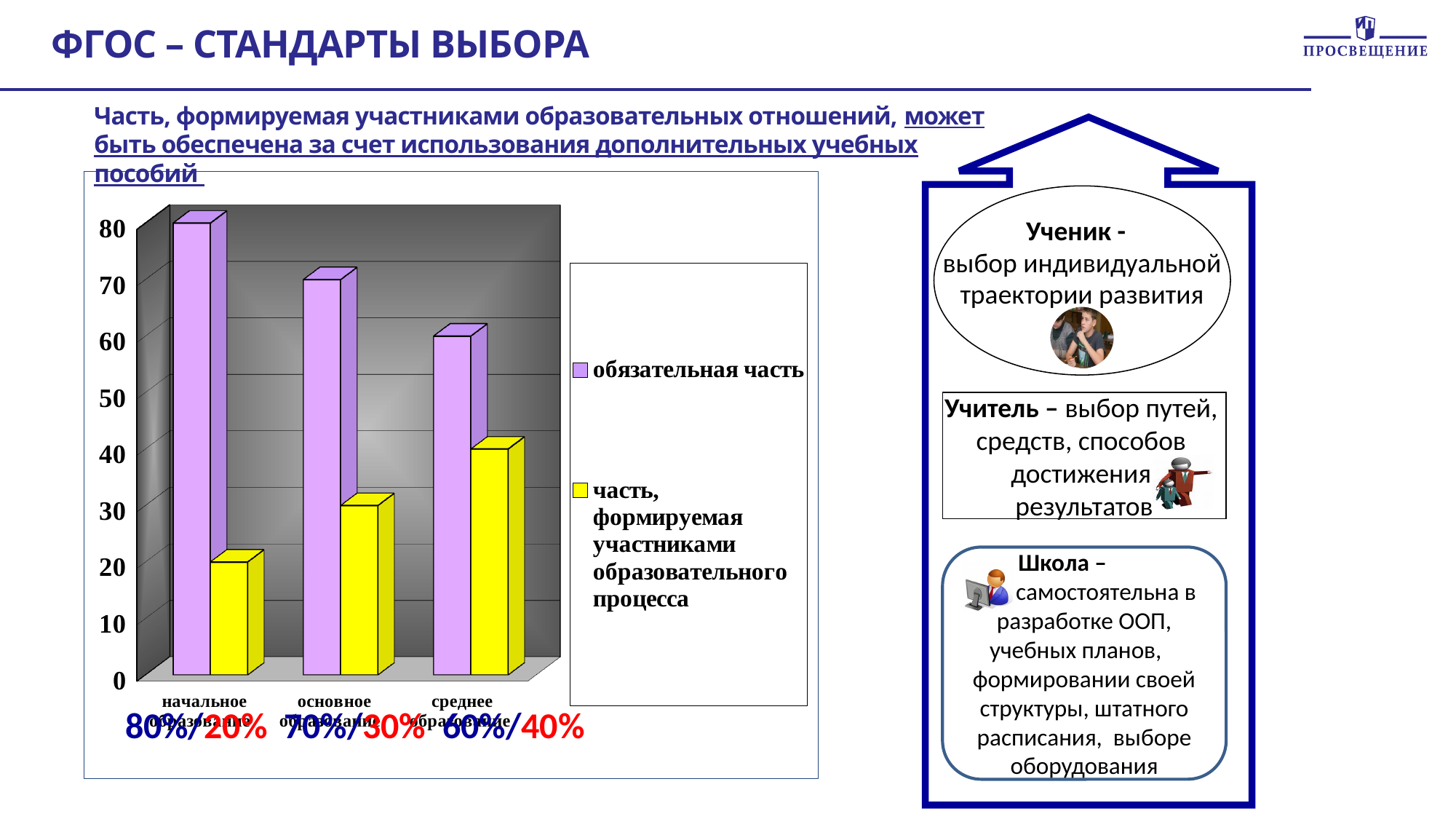
What is the value of 'обязательная часть' for 'начальное образование'? 80 For which category is 'часть, формируемая участниками образовательного процесса' the highest? среднее образование What is the value of 'часть, формируемая участниками образовательного процесса' for 'среднее образование'? 40 How many series does the chart legend list? 2 For which category is 'обязательная часть' the lowest? среднее образование How many categories are shown on the x axis of the chart? 3 What is the difference between 'обязательная часть' and 'часть, формируемая участниками образовательного процесса' for 'начальное образование'? 60 What kind of chart is shown on the slide? bar chart What colour are the bars for 'обязательная часть'? purple Which is larger for 'основное образование': 'обязательная часть' or 'часть, формируемая участниками образовательного процесса'? обязательная часть What is the value of 'обязательная часть' for 'основное образование'? 70 Does 'обязательная часть' rise or fall from 'начальное образование' to 'среднее образование'? fall